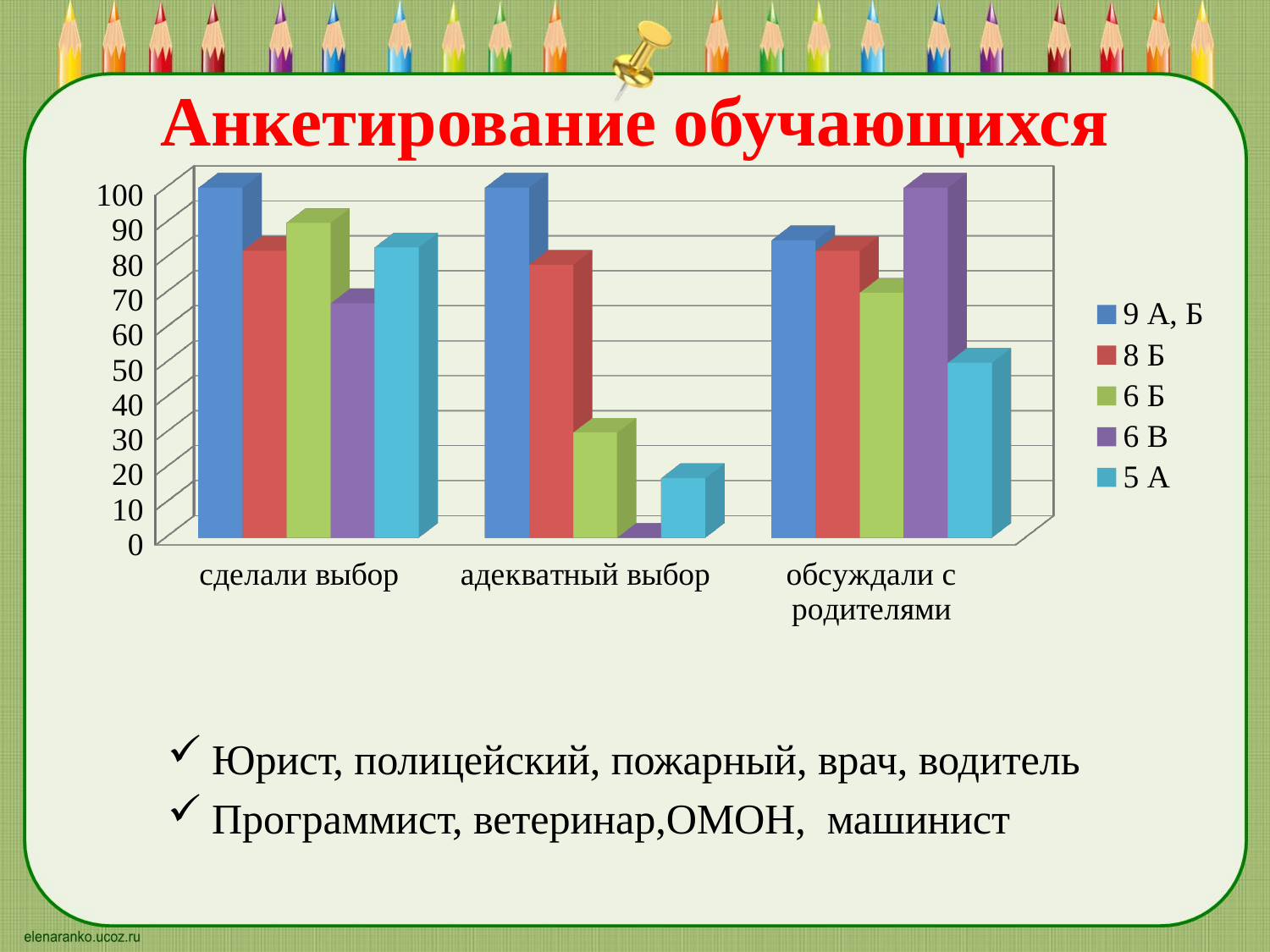
How many series does the chart legend list? 5 What kind of chart is shown on the slide? bar chart In the category "адекватный выбор", which is larger: the value for 6 Б or the value for 6 В? 6 Б Which series has the lowest value in the category "сделали выбор"? 6 В Which series has the highest value in the category "обсуждали с родителями"? 6 В How many categories are shown along the x axis of the chart? 3 Which series has the lowest value in the category "обсуждали с родителями"? 5 А What is the title of the slide above the chart? Анкетирование обучающихся Which series has the highest value in the category "адекватный выбор"? 9 А, Б Is the value for 6 Б in the category "адекватный выбор" greater or less than 50? less Which series has the lowest value in the category "адекватный выбор"? 6 В Is the value for 9 А, Б in the category "обсуждали с родителями" greater or less than 70? greater